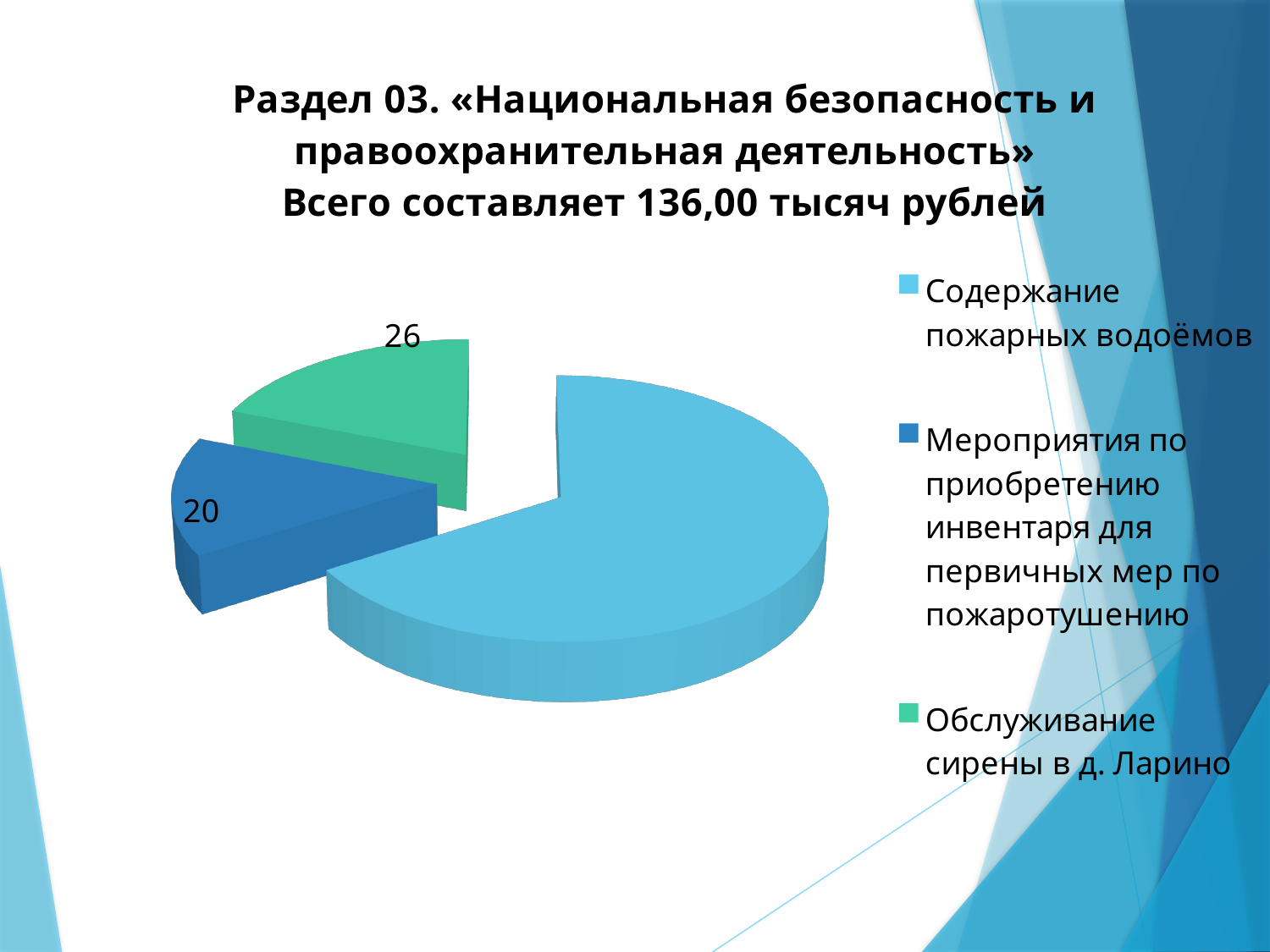
Which category has the largest slice of the pie? Содержание пожарных водоёмов What total amount does the slide title state for Раздел 03? 136,00 тысяч рублей Which is larger: the value for «Обслуживание сирены в д. Ларино» or the value for «Мероприятия по приобретению инвентаря для первичных мер по пожаротушению»? Обслуживание сирены в д. Ларино What is the value shown for «Мероприятия по приобретению инвентаря для первичных мер по пожаротушению»? 20 How many slices does the pie chart have? 3 Which category has the smallest slice of the pie? Мероприятия по приобретению инвентаря для первичных мер по пожаротушению Which legend entry is shown in green? Обслуживание сирены в д. Ларино What kind of chart is shown on the slide? pie chart What is the difference between the values for «Обслуживание сирены в д. Ларино» and «Мероприятия по приобретению инвентаря для первичных мер по пожаротушению»? 6 What is the value shown for «Обслуживание сирены в д. Ларино»? 26 How many entries does the legend list? 3